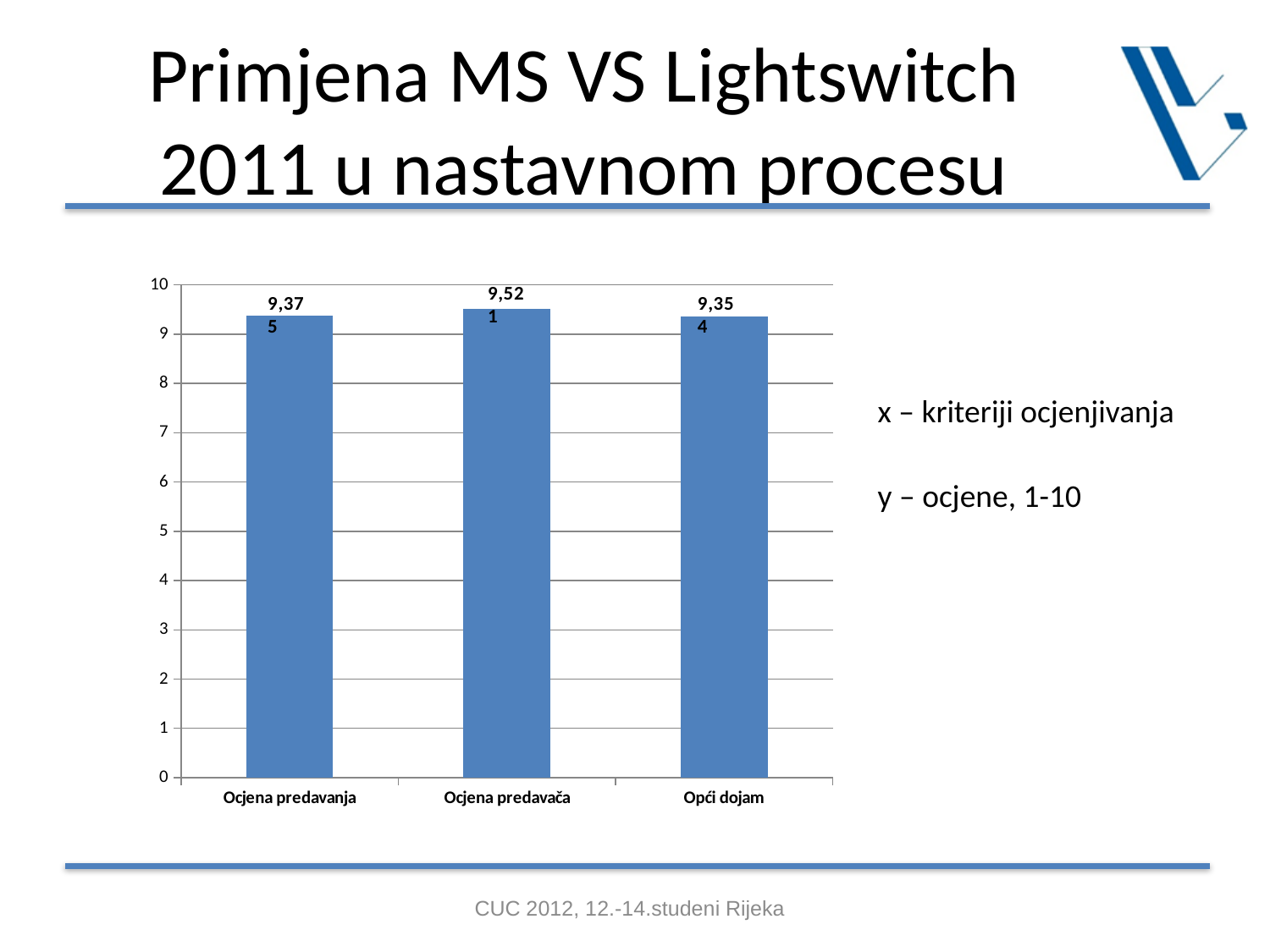
Is the value for Ocjena predavača greater or less than 9? greater According to the text next to the chart, what does the y axis represent? ocjene, 1-10 Is the value for Opći dojam greater or less than 10? less How many categories are shown on the x axis of the chart? 3 What type of chart is shown on the slide? bar chart Which category has the highest value in the chart? Ocjena predavača What is the value shown for Ocjena predavanja? 9,375 What is the value shown for Opći dojam? 9,354 Which is larger, the value for Ocjena predavača or the value for Opći dojam? Ocjena predavača What is the maximum value shown on the y axis of the chart? 10 Which category has the lowest value in the chart? Opći dojam What is the value shown for Ocjena predavača? 9,521